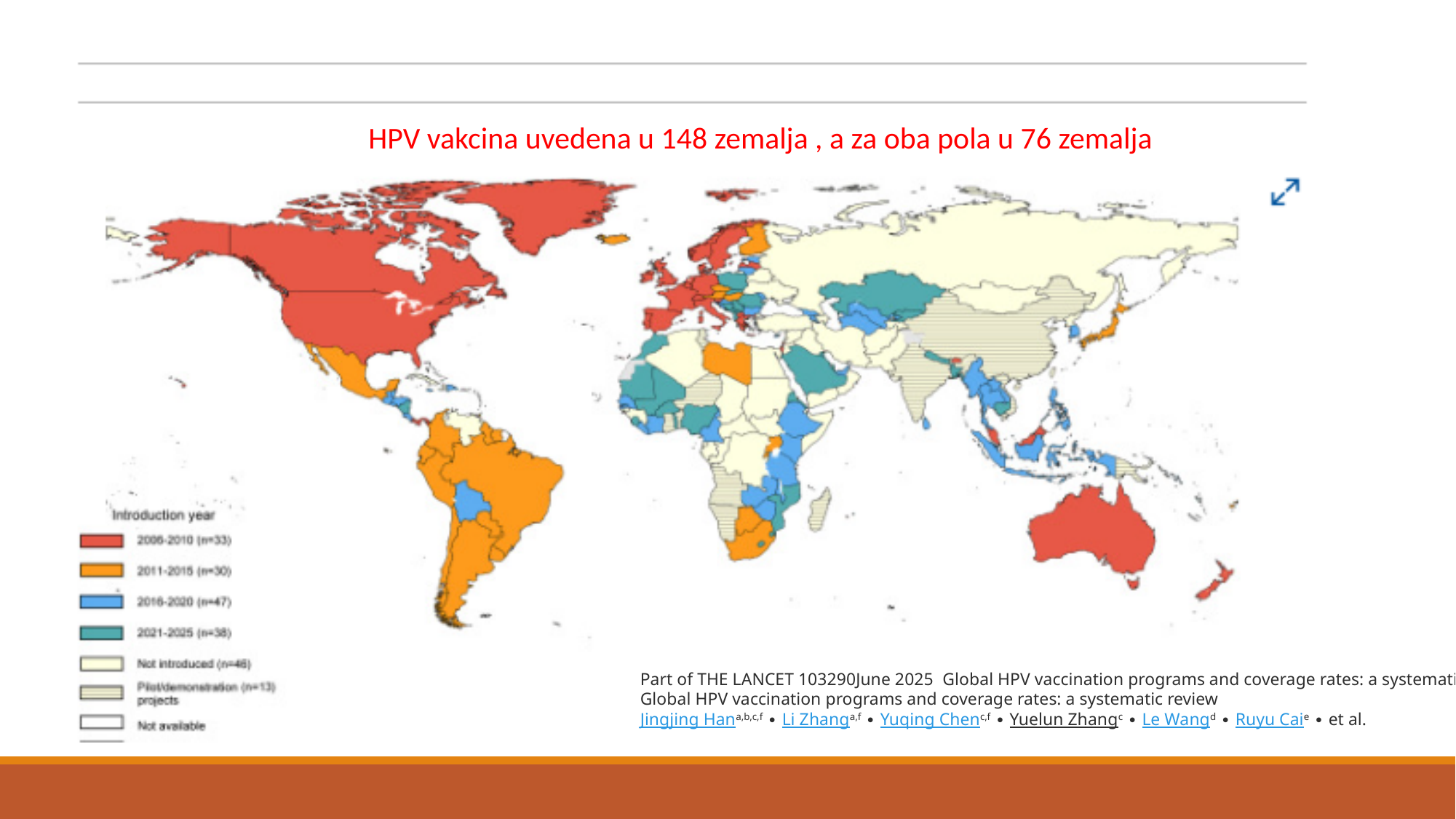
How many countries are listed as 'Not introduced' in the legend? 46 How many countries are in the 2006-2010 introduction year category according to the legend? 33 Which colour represents the 2006-2010 introduction year category on the map? Red Which introduction year period has the lowest number of countries in the legend? 2011-2015 What kind of chart is shown on the slide? A world map (choropleth map) How many countries are in the 2021-2025 introduction year category according to the legend? 38 How many countries have pilot/demonstration projects according to the legend? 13 What is the difference between the number of countries in the 2016-2020 category and the 2011-2015 category? 17 How many countries are in the 2016-2020 introduction year category according to the legend? 47 How many countries are in the 2011-2015 introduction year category according to the legend? 30 What is the title of the map's legend? Introduction year Which introduction year period has the highest number of countries in the legend? 2016-2020